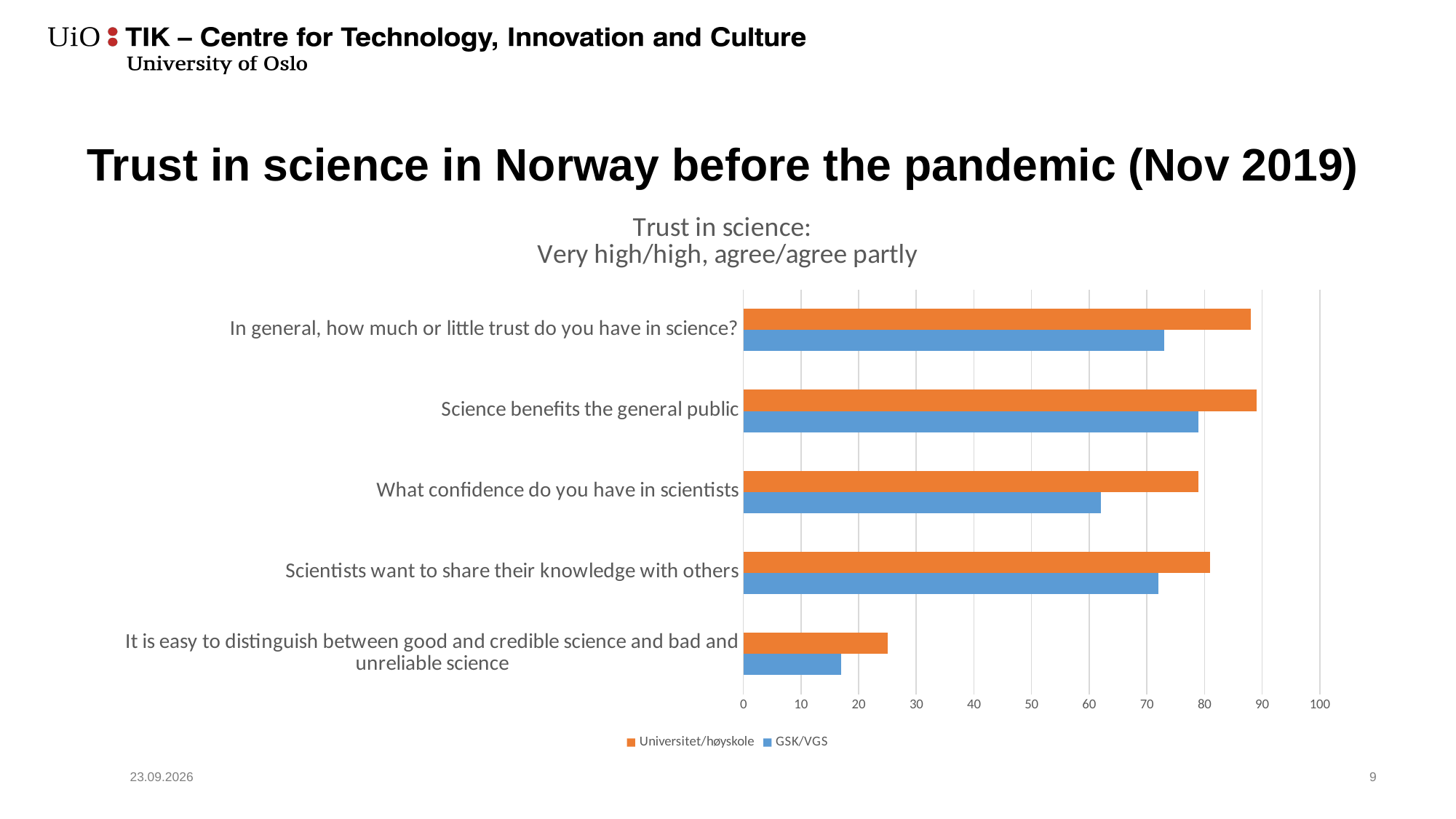
Which category has the lowest value for Universitet/høyskole? It is easy to distinguish between good and credible science and bad and unreliable science How many categories (questions) are plotted on the chart? 5 Which category has the highest value for GSK/VGS? Science benefits the general public For 'What confidence do you have in scientists', which series has the larger value, Universitet/høyskole or GSK/VGS? Universitet/høyskole Is the GSK/VGS value for 'What confidence do you have in scientists' greater or less than 70? less Is the GSK/VGS value for 'Science benefits the general public' greater or less than 70? greater Which colour represents the GSK/VGS series? blue What is the title of the chart? Trust in science: Very high/high, agree/agree partly How many series does the legend list? 2 Is the Universitet/høyskole value for 'It is easy to distinguish between good and credible science and bad and unreliable science' greater or less than 30? less What kind of chart is shown on the slide? bar chart